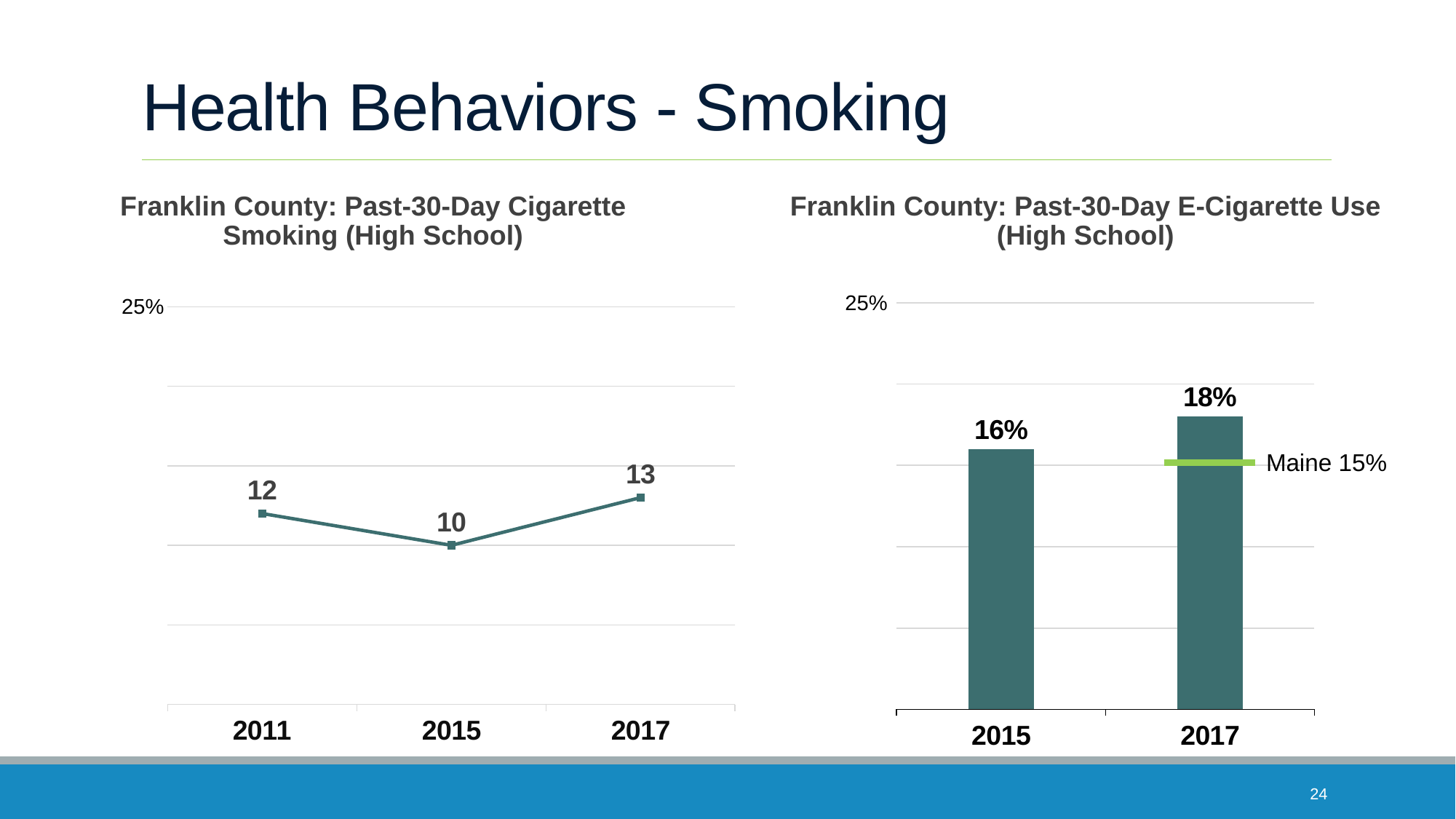
In the Franklin County: Past-30-Day Cigarette Smoking (High School) chart, what is the value for 2017? 13 What kind of chart is the Franklin County: Past-30-Day E-Cigarette Use (High School) chart? bar chart In the Franklin County: Past-30-Day E-Cigarette Use (High School) chart, what is the value for 2015? 16% In the Franklin County: Past-30-Day Cigarette Smoking (High School) chart, how many data points are plotted? 3 In the Franklin County: Past-30-Day Cigarette Smoking (High School) chart, what is the difference between the 2011 and 2015 values? 2 In the Franklin County: Past-30-Day E-Cigarette Use (High School) chart, what is the value for 2017? 18% In the Franklin County: Past-30-Day Cigarette Smoking (High School) chart, what is the value for 2015? 10 What kind of chart is the Franklin County: Past-30-Day Cigarette Smoking (High School) chart? line chart In the Franklin County: Past-30-Day E-Cigarette Use (High School) chart, what is the difference between the 2017 and 2015 values? 2% In the Franklin County: Past-30-Day E-Cigarette Use (High School) chart, what value does the Maine reference line show? 15% In the Franklin County: Past-30-Day Cigarette Smoking (High School) chart, which year has the lowest value? 2015 In the Franklin County: Past-30-Day Cigarette Smoking (High School) chart, which year has the highest value? 2017